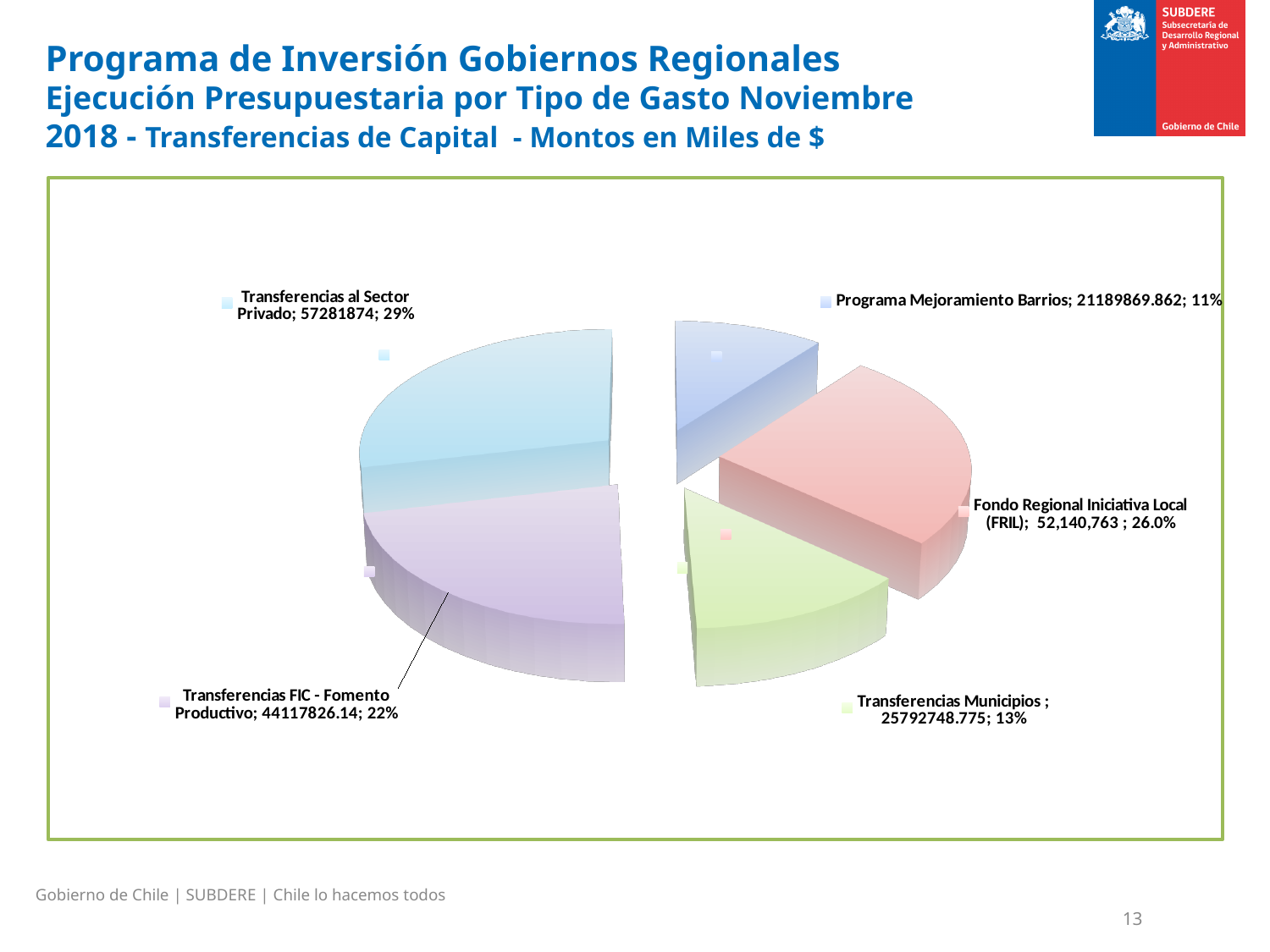
What is the difference in percentage share between Transferencias al Sector Privado and Programa Mejoramiento Barrios? 18% What kind of chart is shown on the slide? pie chart How many slices does the pie chart have? 5 Which category has the largest slice of the pie? Transferencias al Sector Privado What share of the pie does Fondo Regional Iniciativa Local (FRIL) represent? 26.0% What is the value shown for Fondo Regional Iniciativa Local (FRIL)? 52,140,763 What is the value shown for Transferencias al Sector Privado? 57281874 What is the value shown for Transferencias Municipios? 25792748.775 What is the value shown for Programa Mejoramiento Barrios? 21189869.862 Which category has the smallest slice of the pie? Programa Mejoramiento Barrios What share of the pie does Transferencias FIC - Fomento Productivo represent? 22% Which is larger, the value for Transferencias Municipios or the value for Programa Mejoramiento Barrios? Transferencias Municipios